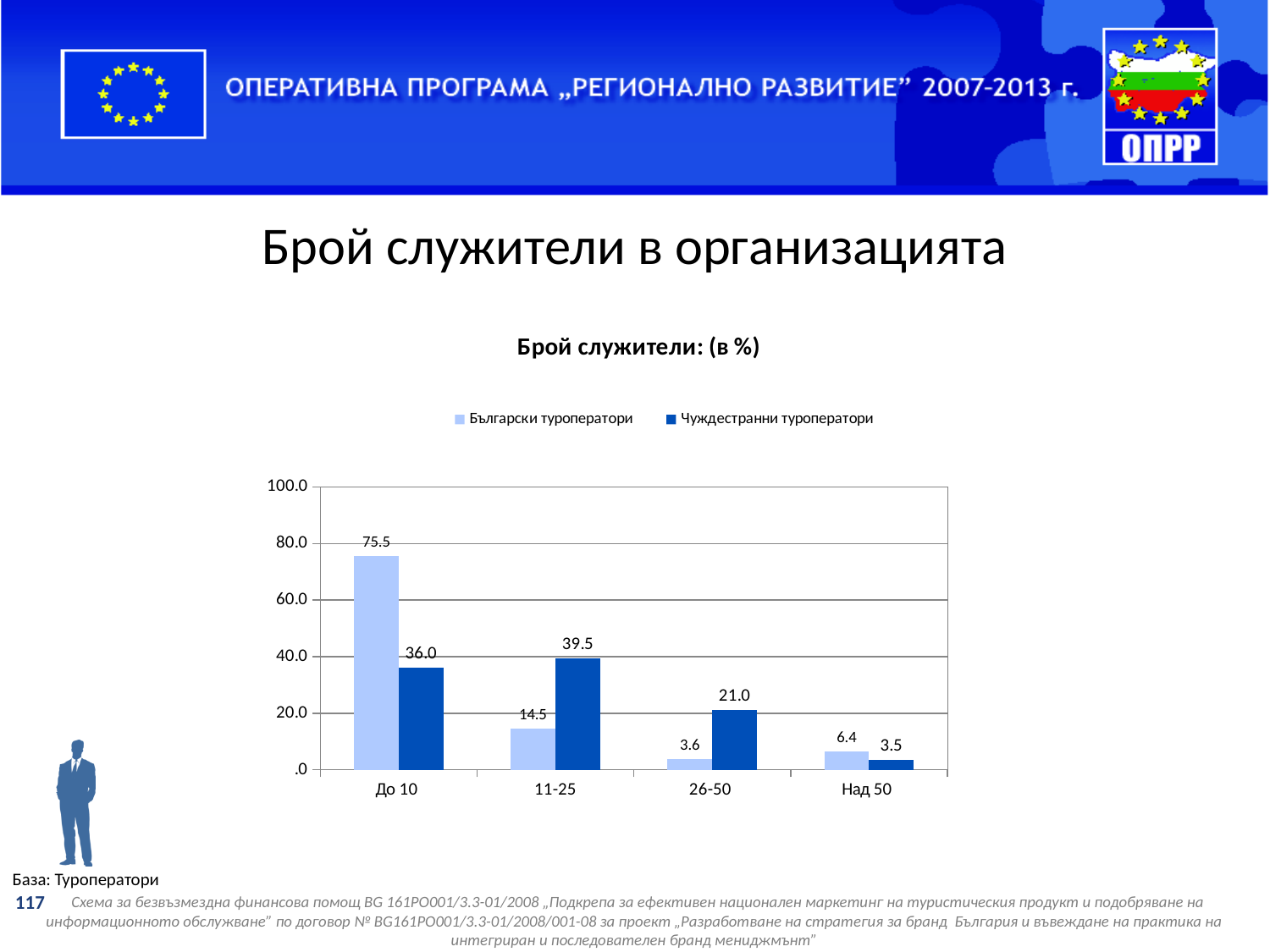
Which category has the lowest value for Чуждестранни туроператори? Над 50 What is the value for Български туроператори in the Над 50 category? 6.4 What kind of chart is shown on the slide? Bar chart In the 11-25 category, which series has the larger value, Български туроператори or Чуждестранни туроператори? Чуждестранни туроператори What is the difference between Български туроператори and Чуждестранни туроператори in the До 10 category? 39.5 What is the value for Чуждестранни туроператори in the 26-50 category? 21.0 What is the title of the chart? Брой служители: (в %) What is the value for Чуждестранни туроператори in the 11-25 category? 39.5 What is the value for Български туроператори in the До 10 category? 75.5 How many categories are shown on the x axis? 4 Which category has the highest value for Български туроператори? До 10 How many series does the legend list? 2